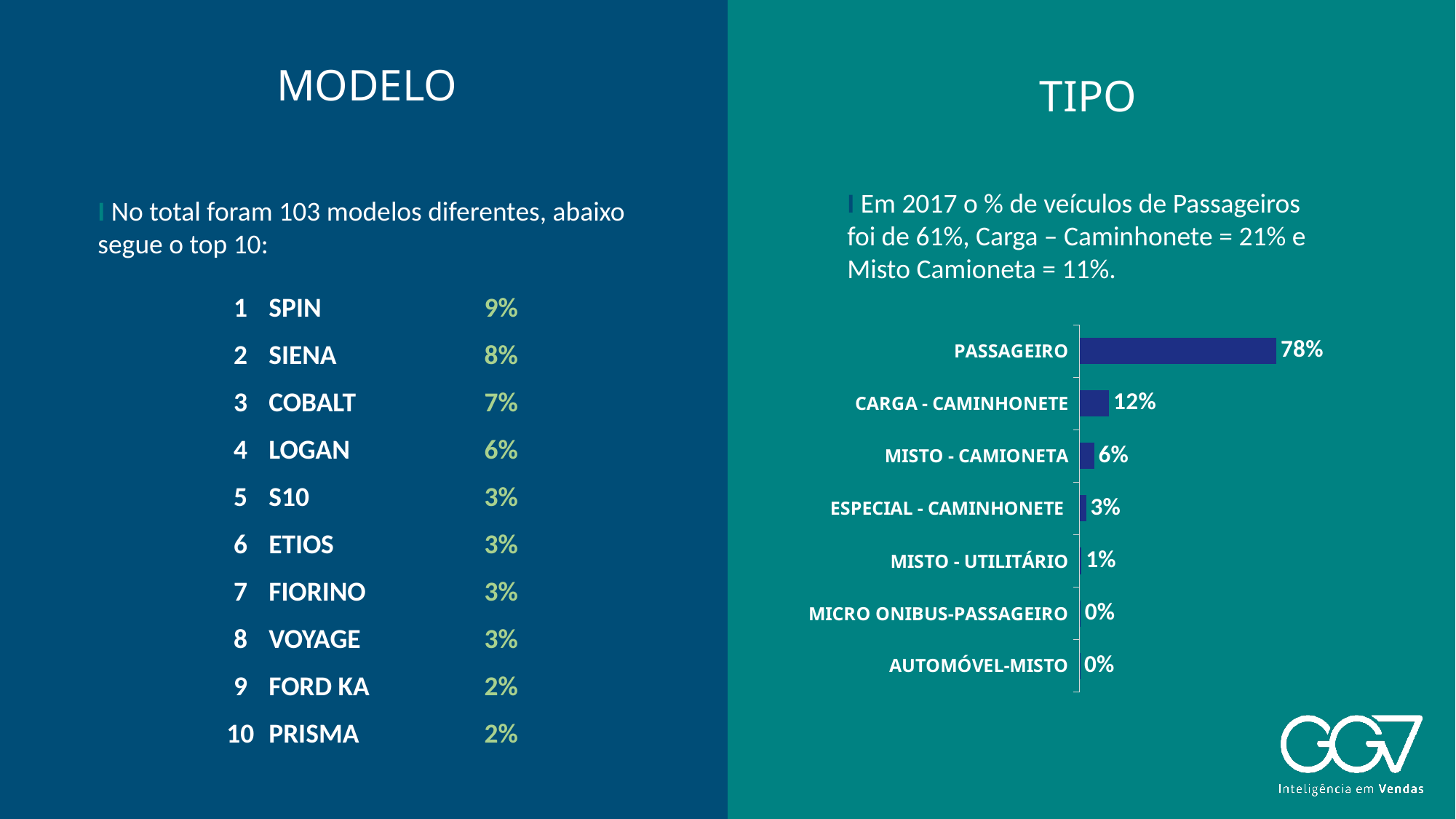
In the TIPO chart, what is the value for CARGA - CAMINHONETE? 12% In the TIPO chart, what is the value for MISTO - UTILITÁRIO? 1% In the TIPO chart, what is the difference between CARGA - CAMINHONETE and MISTO - CAMIONETA? 6% In the TIPO chart, what value is shown for AUTOMÓVEL-MISTO? 0% In the TIPO chart, which is larger: MISTO - CAMIONETA or ESPECIAL - CAMINHONETE? MISTO - CAMIONETA What kind of chart is the TIPO chart? Bar chart In the TIPO chart, what is the value for PASSAGEIRO? 78% In the TIPO chart, what is the value for MISTO - CAMIONETA? 6% How many categories are shown in the TIPO chart? 7 In the TIPO chart, what is the difference between PASSAGEIRO and CARGA - CAMINHONETE? 66% In the TIPO chart, which category has the highest value? PASSAGEIRO In the TIPO chart, what is the value for ESPECIAL - CAMINHONETE? 3%